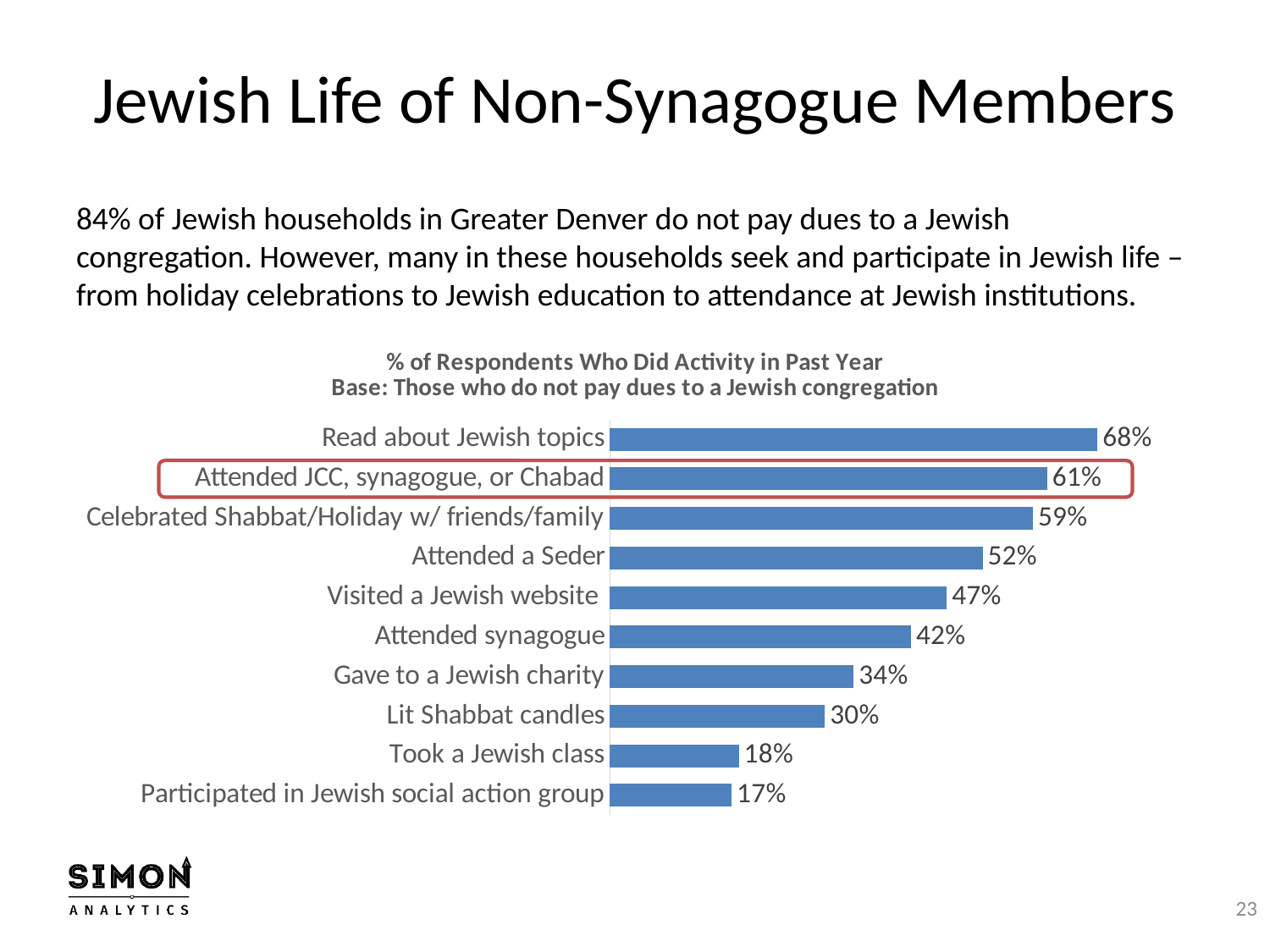
What percentage of respondents attended JCC, synagogue, or Chabad? 61% Which activity has the highest percentage of respondents? Read about Jewish topics Which is larger: the value for 'Gave to a Jewish charity' or 'Visited a Jewish website'? Visited a Jewish website How many activities are shown in the chart? 10 What is the title of the chart? % of Respondents Who Did Activity in Past Year Base: Those who do not pay dues to a Jewish congregation What kind of chart is shown on the slide? Bar chart Which activity has the lowest percentage of respondents? Participated in Jewish social action group What is the value for 'Lit Shabbat candles'? 30% What is the difference between the percentage who attended a Seder and the percentage who attended synagogue? 10% Which activity is highlighted with a red outline on the chart? Attended JCC, synagogue, or Chabad What is the difference between 'Read about Jewish topics' and 'Took a Jewish class'? 50% What percentage of respondents read about Jewish topics in the past year? 68%